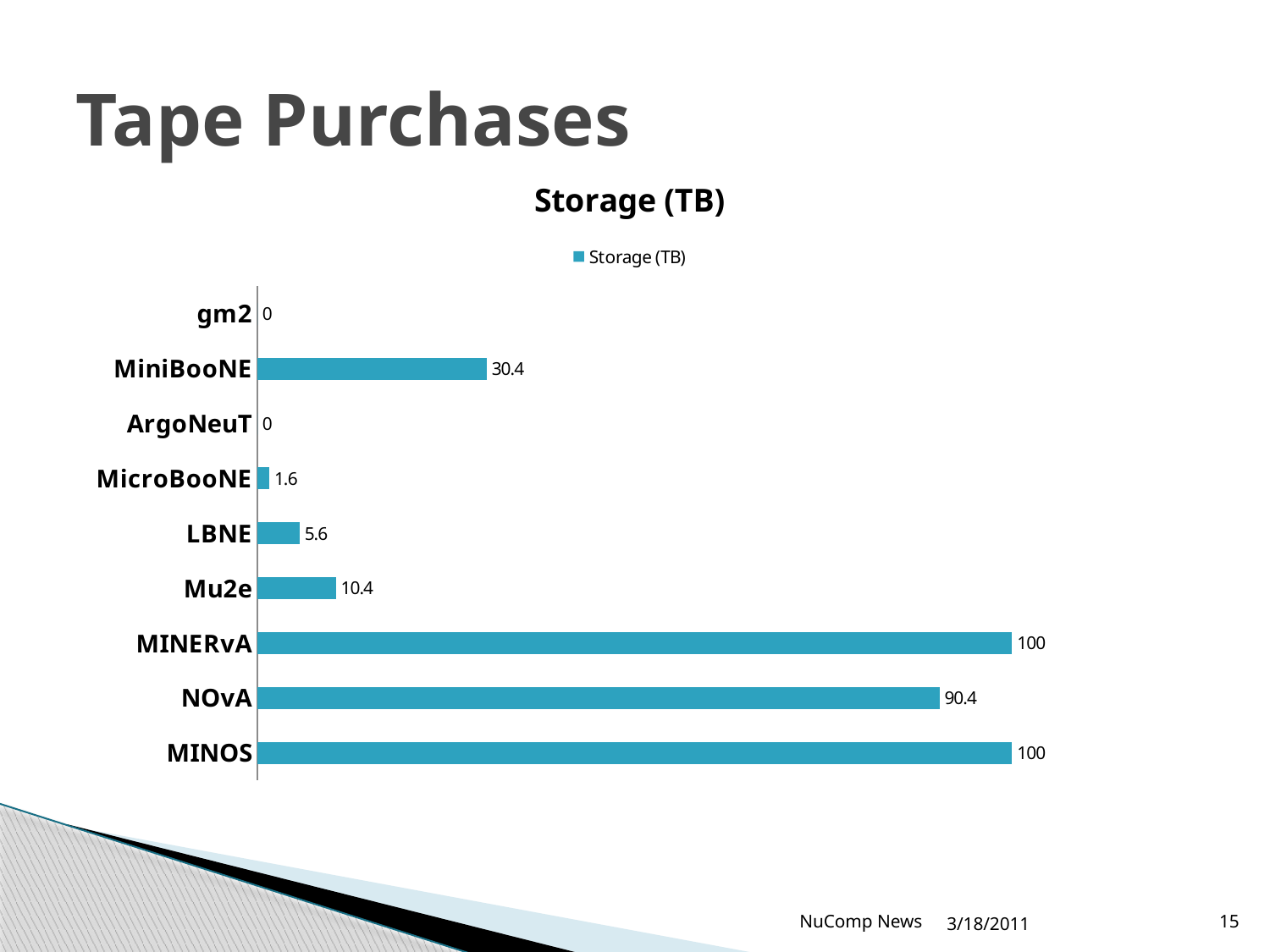
What is the Storage (TB) value for LBNE? 5.6 Which has a larger Storage (TB) value, LBNE or MicroBooNE? LBNE What is the difference in Storage (TB) between MINERvA and NOvA? 9.6 What is the Storage (TB) value for NOvA? 90.4 How many categories are shown in the chart? 9 What kind of chart is shown on the slide? Bar chart What is the difference in Storage (TB) between MiniBooNE and Mu2e? 20 What is the Storage (TB) value for MicroBooNE? 1.6 What is the Storage (TB) value for MiniBooNE? 30.4 Which has a larger Storage (TB) value, NOvA or MiniBooNE? NOvA What is the Storage (TB) value for Mu2e? 10.4 What is the Storage (TB) value for ArgoNeuT? 0